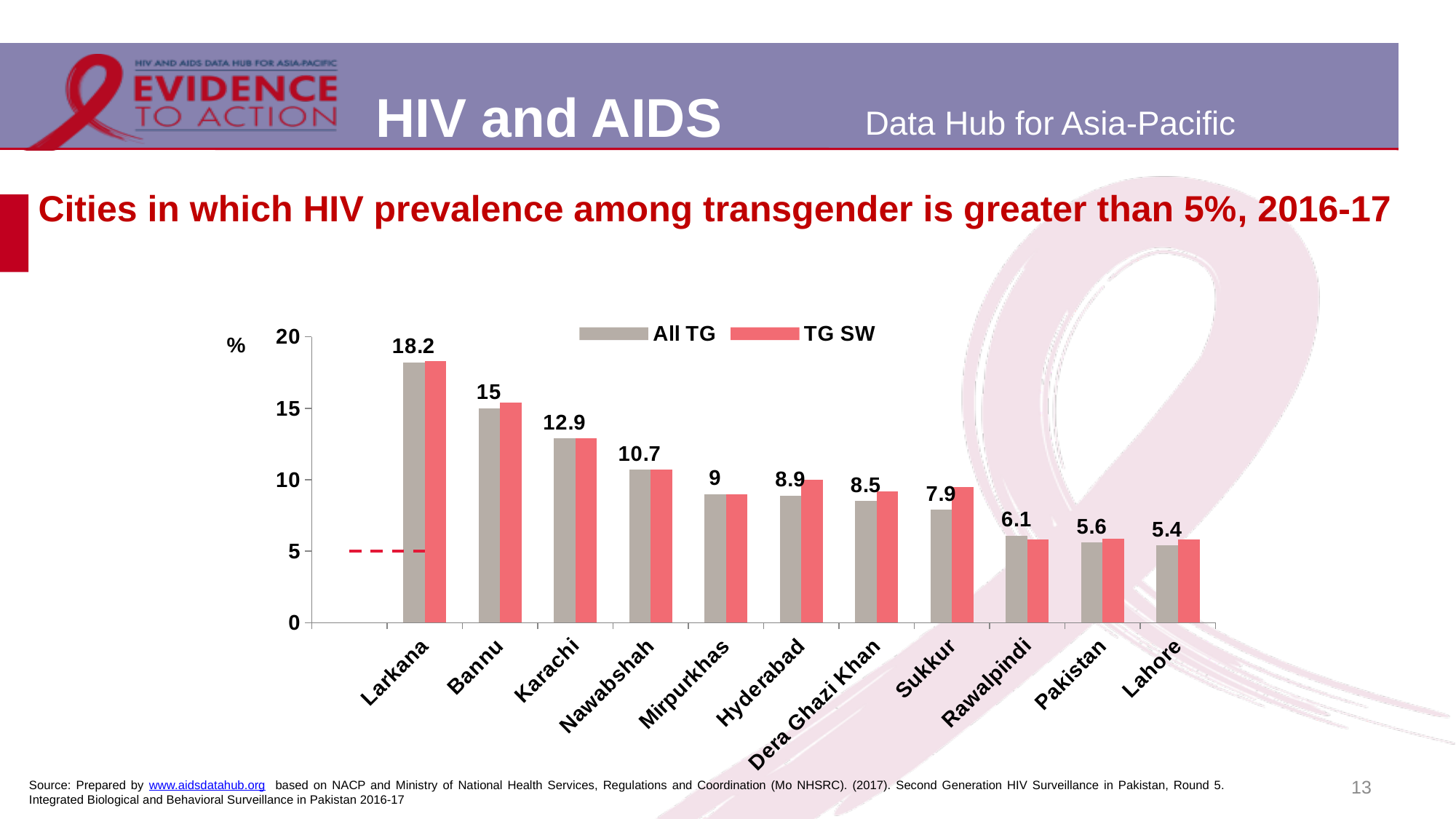
Do the All TG values rise or fall from left to right along the x axis? Fall What is the All TG value shown for Karachi? 12.9 What is the difference between the All TG values for Larkana and Bannu? 3.2 Which category has the lowest All TG value on the chart? Lahore How many series does the legend list? 2 What is the All TG value shown for Rawalpindi? 6.1 Which has a larger All TG value, Nawabshah or Sukkur? Nawabshah What kind of chart is shown on the slide? Bar chart What is the All TG HIV prevalence value for Larkana? 18.2 How many categories are shown on the x axis? 11 Is the TG SW value for Larkana greater or less than 15? greater Which city has the highest All TG HIV prevalence? Larkana